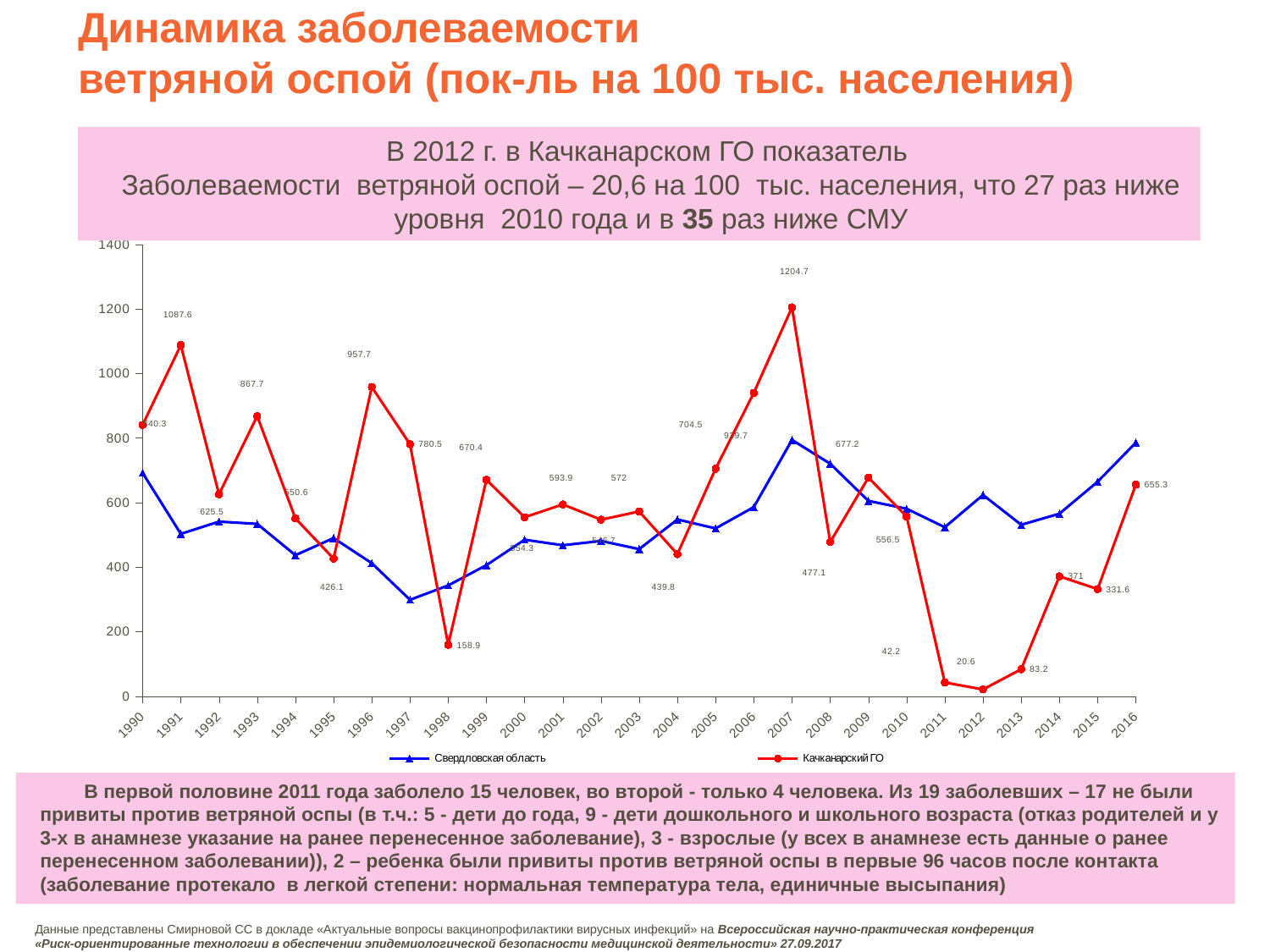
What kind of chart is shown on the slide? line chart In which year is the value for Качканарский ГО highest? 2007 How many series does the legend list? 2 What is the value for Качканарский ГО in 2012? 20.6 Is the value for Свердловская область in 2007 greater or less than 600? greater In which year is the value for Качканарский ГО lowest? 2012 What is the value for Качканарский ГО in 1991? 1087.6 Which year has the larger value for Качканарский ГО, 2011 or 2013? 2013 What is the value for Качканарский ГО in 2016? 655.3 What is the value for Качканарский ГО in 2007? 1204.7 What is the difference between the Качканарский ГО values in 2007 and 2012? 1184.1 How many years are plotted on the x axis? 27